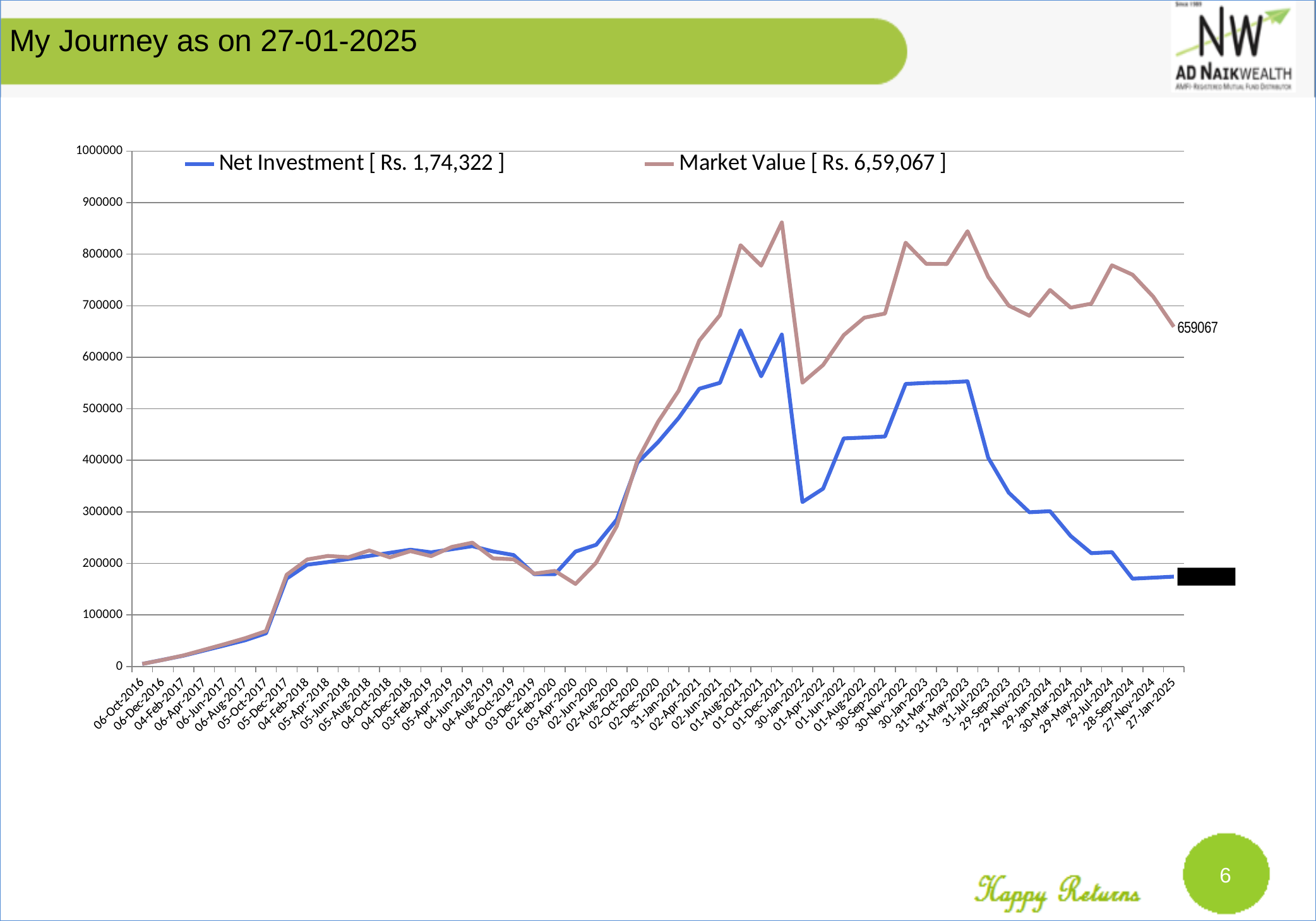
Does the Net Investment line rise or fall from 31-May-2023 to 28-Sep-2024? Fall What colour is the Net Investment line? Blue How many series does the legend list? 2 Is the Net Investment value on 30-Jan-2022 greater or less than 400000? less Is the Net Investment value on 01-Aug-2021 greater or less than 600000? greater Does the Market Value line rise or fall from 06-Oct-2016 to 05-Dec-2017? Rise Is the Net Investment value on 27-Jan-2025 greater or less than 200000? less What type of chart is shown on the slide? Line chart What amount is shown in the legend for Net Investment? Rs. 1,74,322 What is the Market Value on 27-Jan-2025 according to the data label? 659067 On 27-Jan-2025, which is higher, Market Value or Net Investment? Market Value